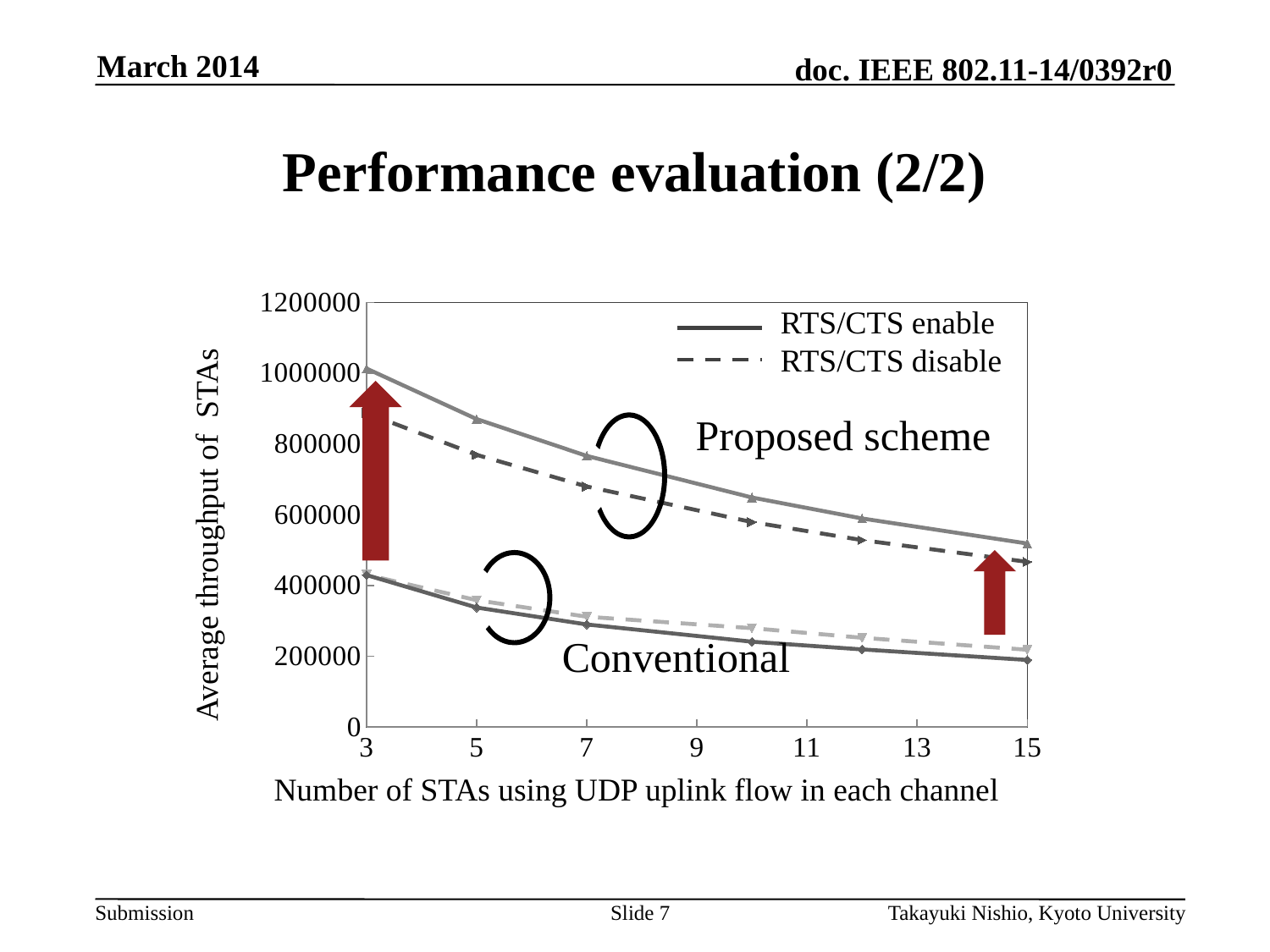
What are the two entries in the chart legend? RTS/CTS enable and RTS/CTS disable How many lines are plotted on the chart? 4 As the number of STAs increases from 3 to 15, does the average throughput of the Proposed scheme with RTS/CTS enable rise or fall? fall Is the value for the Proposed scheme with RTS/CTS enable at 3 STAs greater or less than 800000? greater How many series does the legend list? 2 Is the value for the Proposed scheme with RTS/CTS enable at 15 STAs greater or less than 400000? greater As the number of STAs increases, does the Conventional RTS/CTS disable line rise or fall? fall What is the label of the x axis? Number of STAs using UDP uplink flow in each channel Is the value for the Proposed scheme with RTS/CTS disable at 3 STAs greater or less than 1000000? less What kind of chart is shown on the slide? line chart At 7 STAs, which has the higher average throughput: the Proposed scheme with RTS/CTS enable or the Conventional scheme with RTS/CTS enable? Proposed scheme with RTS/CTS enable